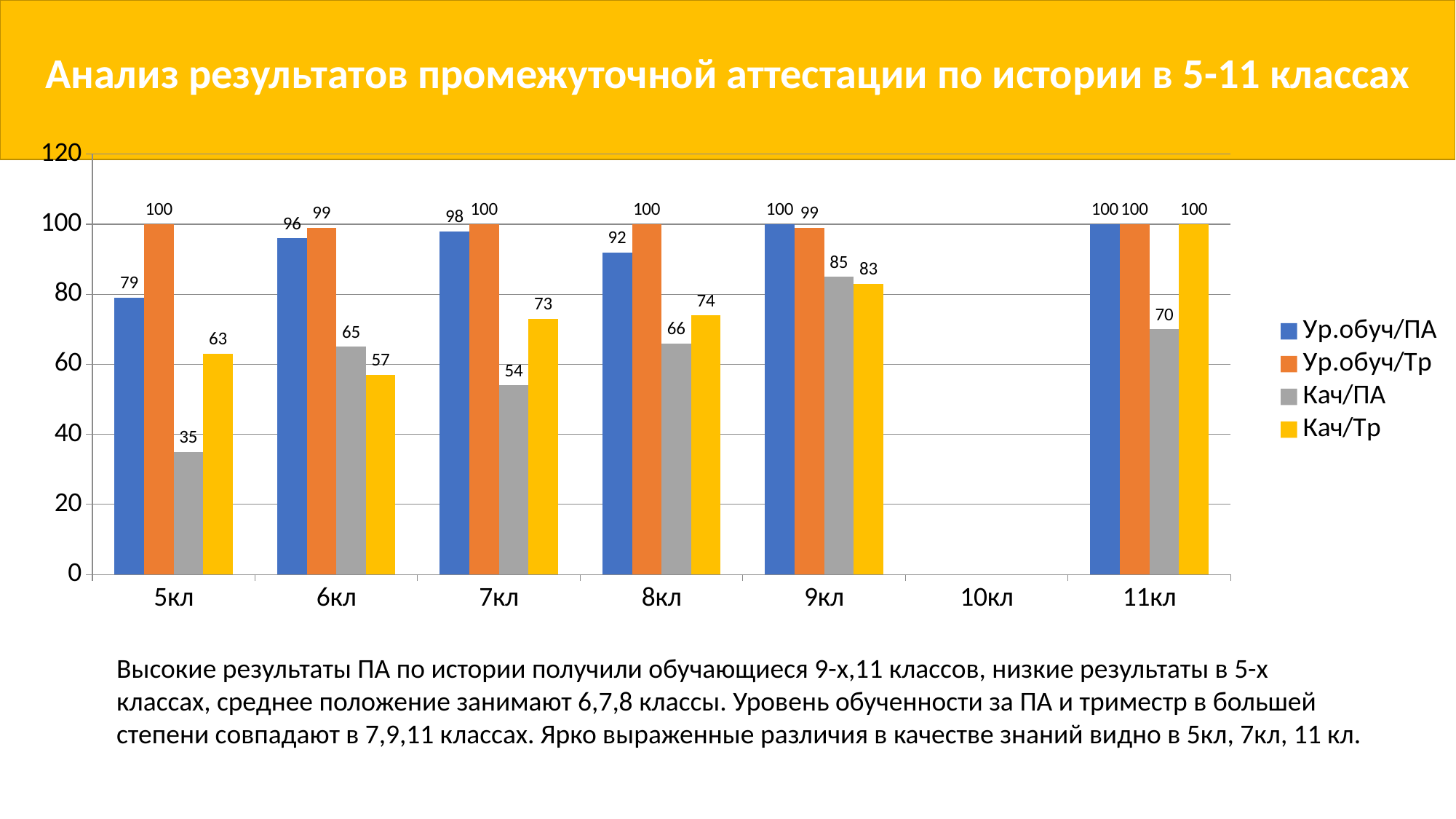
Which category on the x axis has no bars plotted? 10кл What is the value of Кач/ПА for 11кл? 70 Which is larger for 6кл: Кач/ПА or Кач/Тр? Кач/ПА What kind of chart is shown on the slide? Bar chart Which class has the highest Кач/ПА value? 9кл How many class categories are shown on the x axis? 7 What is the value of Кач/Тр for 7кл? 73 How many series does the legend list? 4 Which class has the lowest Кач/ПА value? 5кл What is the value of Ур.обуч/ПА for 5кл? 79 What is the value of Кач/ПА for 9кл? 85 What is the difference between Кач/Тр and Кач/ПА for 5кл? 28